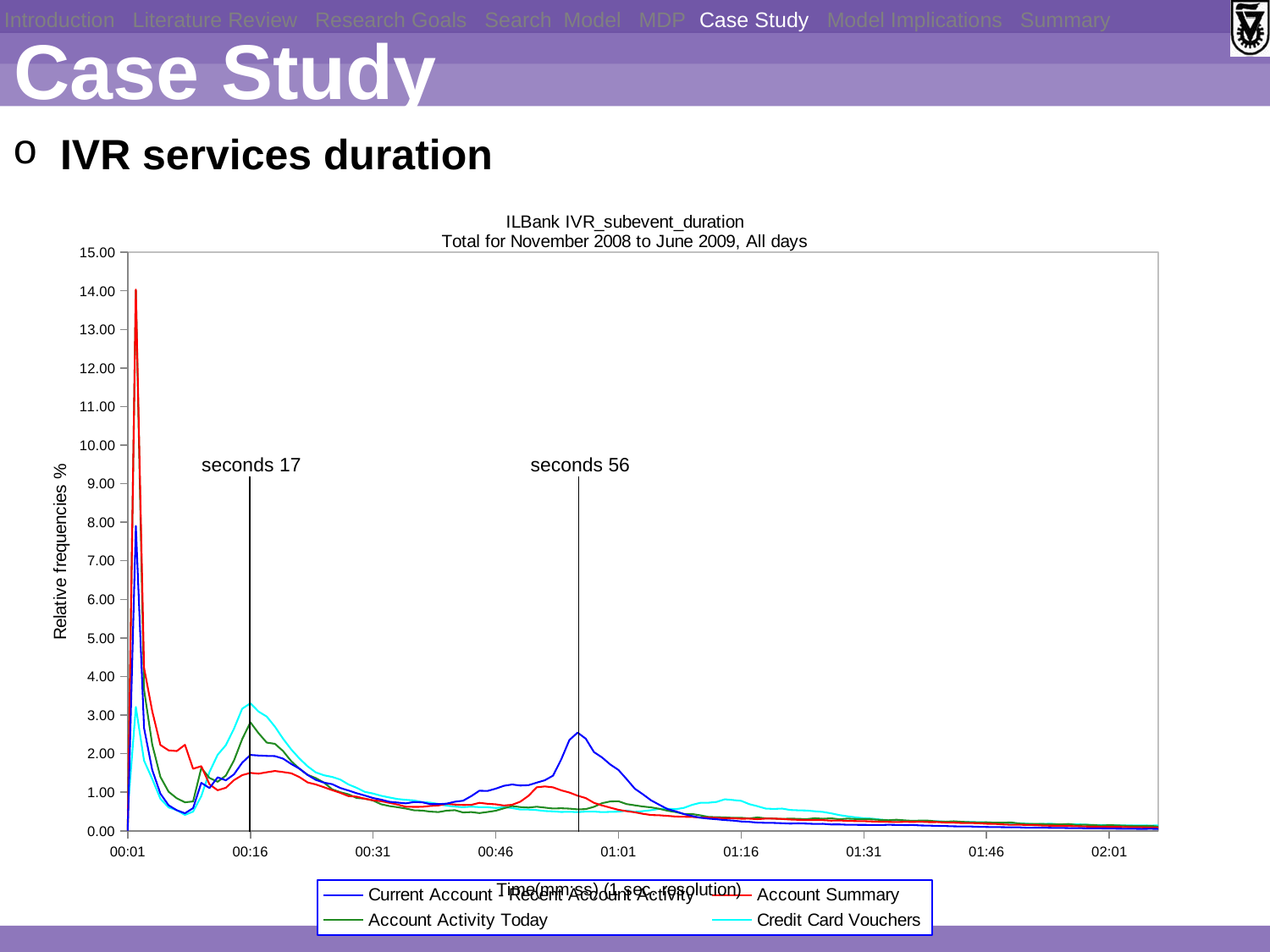
Near 00:16, which series is higher: Credit Card Vouchers or Account Summary? Credit Card Vouchers What is the title of the chart? ILBank IVR_subevent_duration Total for November 2008 to June 2009, All days After the initial peak near 00:01, do the series values generally rise or fall as time increases toward 02:01? fall Is the peak of the Credit Card Vouchers series near 00:16 greater or less than 3.00? greater What is the label of the y axis? Relative frequencies % What are the two time points marked by vertical lines on the chart? seconds 17 and seconds 56 How many tick labels are shown on the x axis? 9 Is the first peak of the Current Account series (near 00:01) greater or less than 7.00? greater Is the peak of the Current Account series near the 'seconds 56' line greater or less than 2.00? greater Which series reaches the highest peak on the chart? Account Summary What kind of chart is shown on the slide? line chart